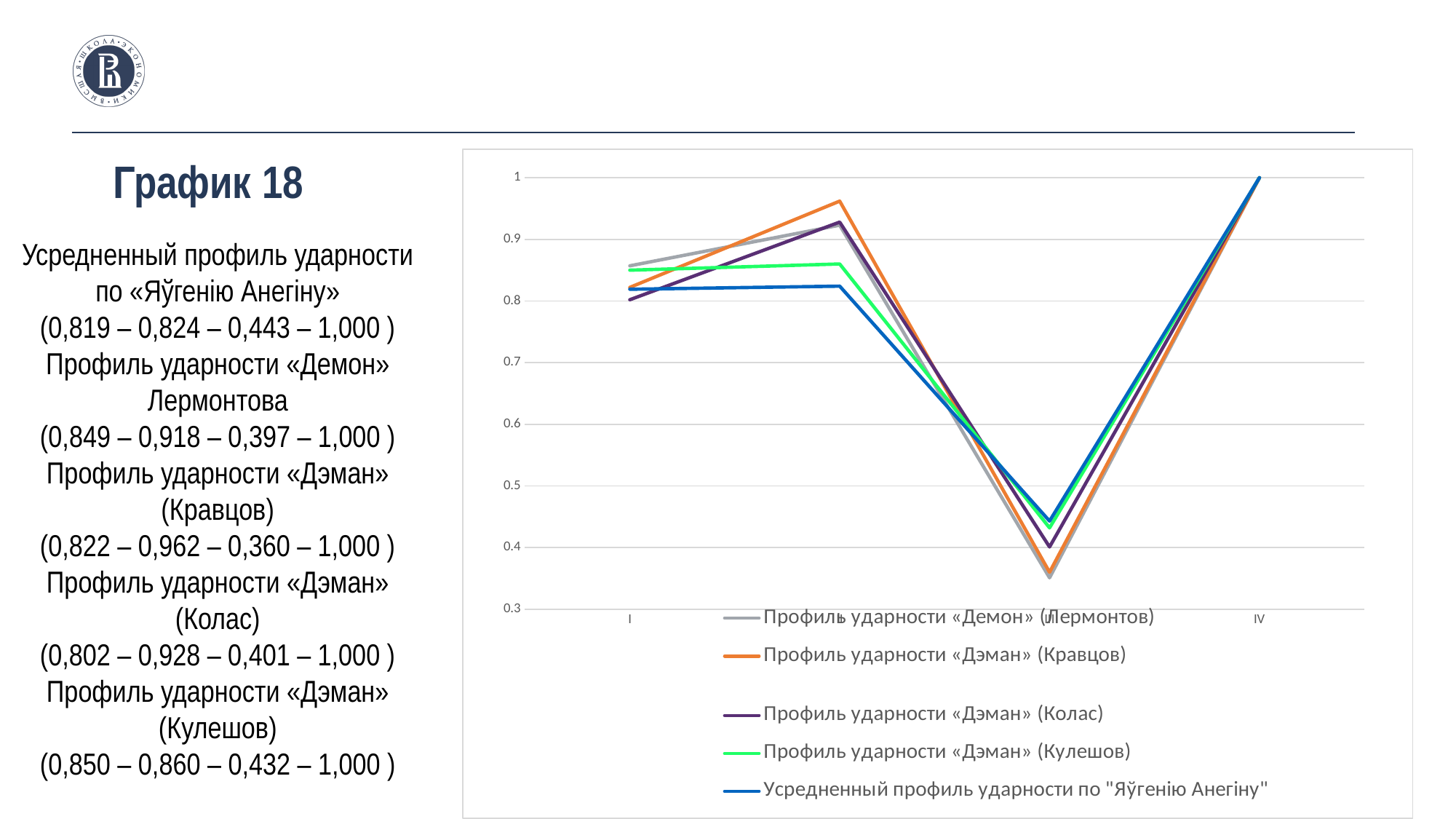
How many series does the chart legend list? 5 Which series has the lowest value at position III? Профиль ударности «Демон» (Лермонтов) How many points (positions on the x axis) does each line in the chart have? 4 Is the value of Профиль ударности «Дэман» (Кулешов) at position II greater or less than 0.9? less What colour is the line for Усредненный профиль ударности по "Яўгенію Анегіну"? Blue Do the lines rise or fall from position III to position IV? Rise Is the value of Профиль ударности «Дэман» (Кравцов) at position III greater or less than 0.4? less What kind of chart is shown on the slide? Line chart At position I, which is larger: Профиль ударности «Дэман» (Кулешов) or Профиль ударности «Дэман» (Колас)? Профиль ударности «Дэман» (Кулешов) What value do all the series reach at position IV? 1,000 Which series has the highest value at position II? Профиль ударности «Дэман» (Кравцов)